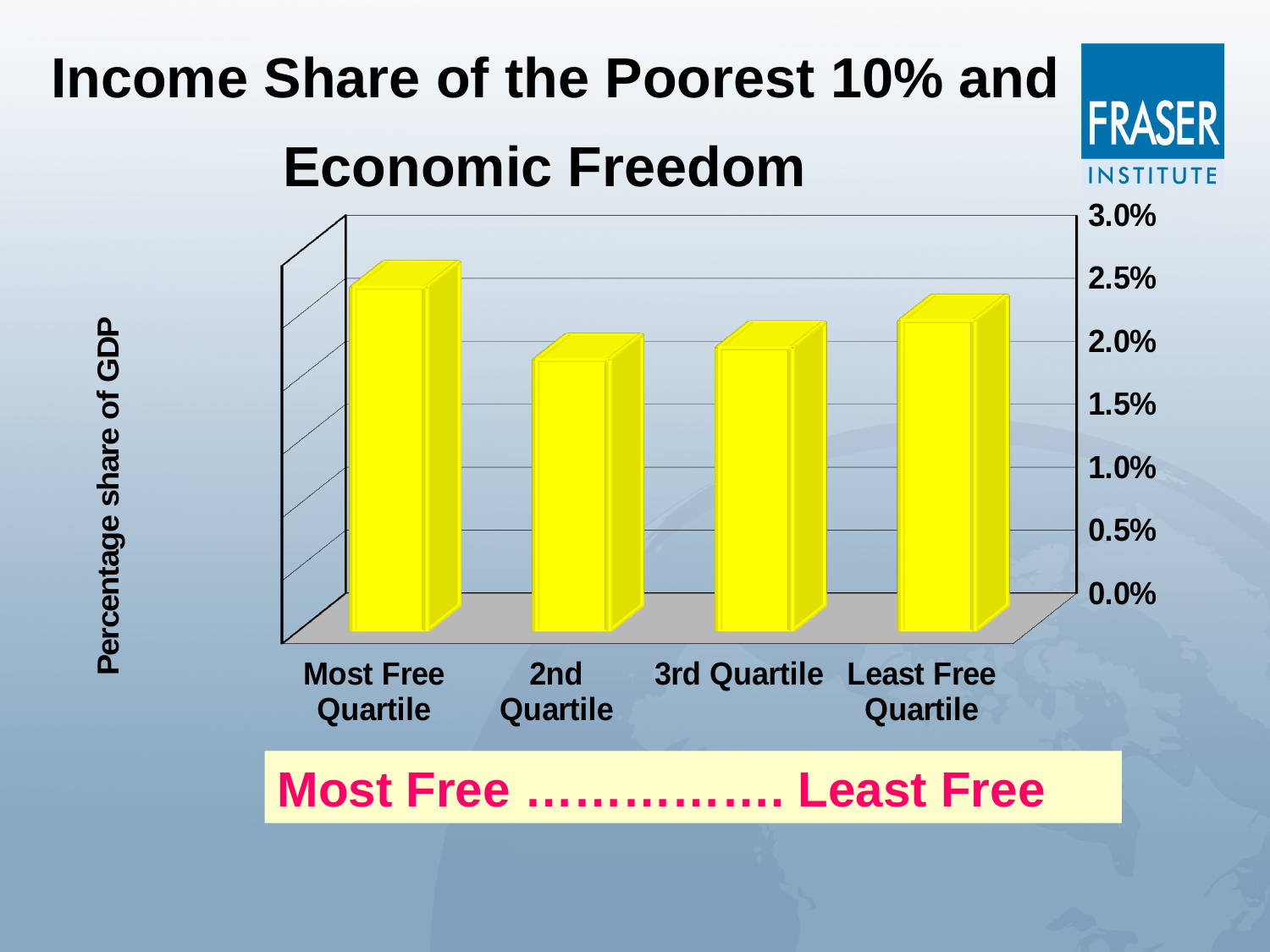
Does the value rise or fall from the Most Free Quartile to the 2nd Quartile? fall What kind of chart is shown on the slide? Bar chart What is the label on the vertical axis of the chart? Percentage share of GDP Is the value for the Least Free Quartile greater or less than 2.5%? less Is the value for the 3rd Quartile greater or less than 1.5%? greater Is the value for the 2nd Quartile greater or less than 2.5%? less Which is larger, the value for the Least Free Quartile or the 2nd Quartile? Least Free Quartile Which is larger, the value for the Most Free Quartile or the 2nd Quartile? Most Free Quartile Which quartile has the highest income share of the poorest 10%? Most Free Quartile How many quartile categories are plotted in the chart? 4